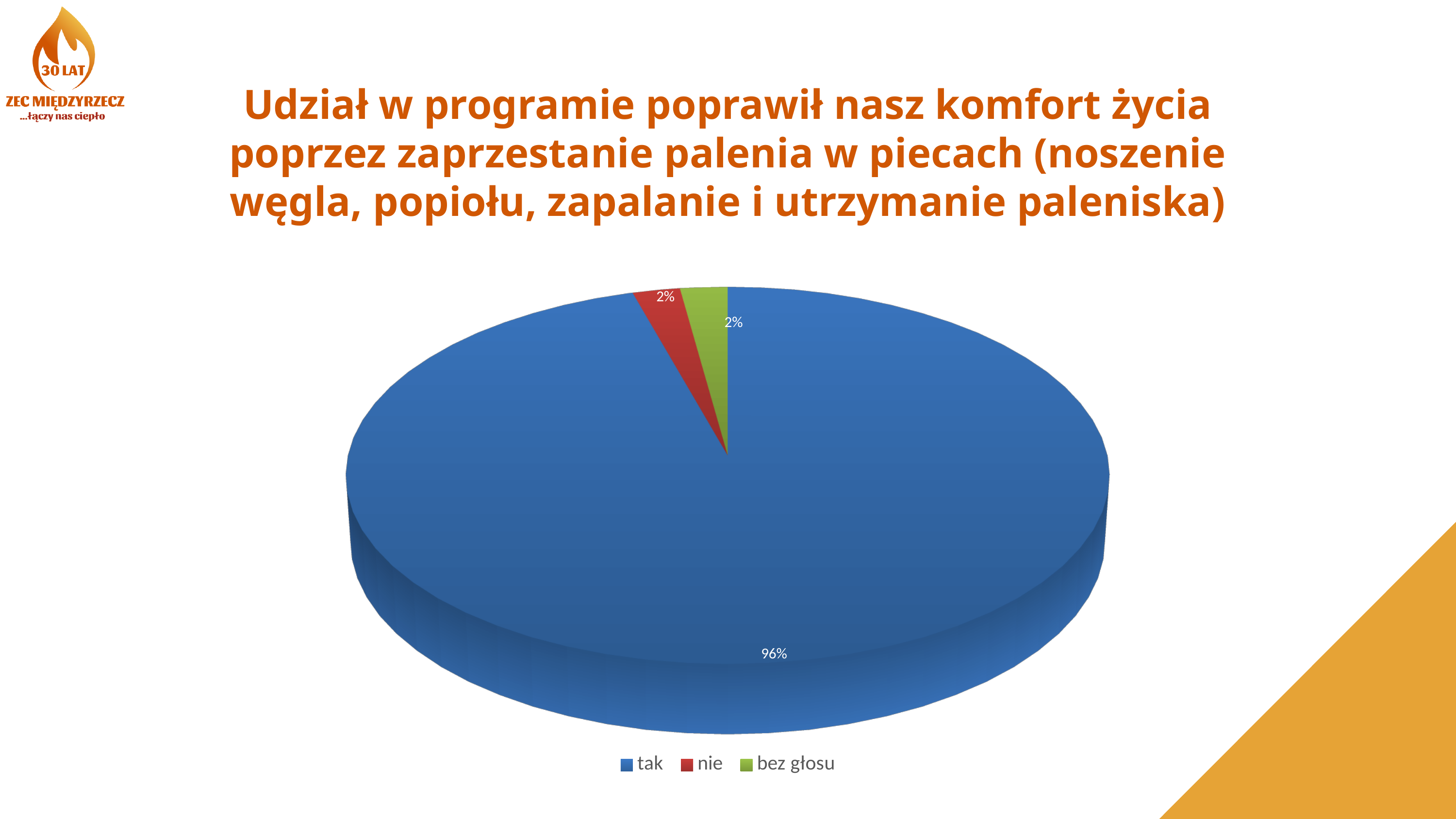
Which category has the largest slice of the pie chart? tak What is the difference in percentage points between the "tak" slice and the "nie" slice? 94 percentage points Which slice is larger, "tak" or "bez głosu"? tak What percentage of the pie chart is the "bez głosu" slice? 2% How many slices does the pie chart have? 3 What percentage of the pie chart is the "nie" slice? 2% How many entries does the legend of the pie chart list? 3 What kind of chart is shown on the slide? pie chart Which legend entry is shown in green? bez głosu What share of the pie does the "tak" slice represent? 96% What colour is the "tak" slice in the pie chart? blue What percentage of the pie chart is the "tak" slice? 96%